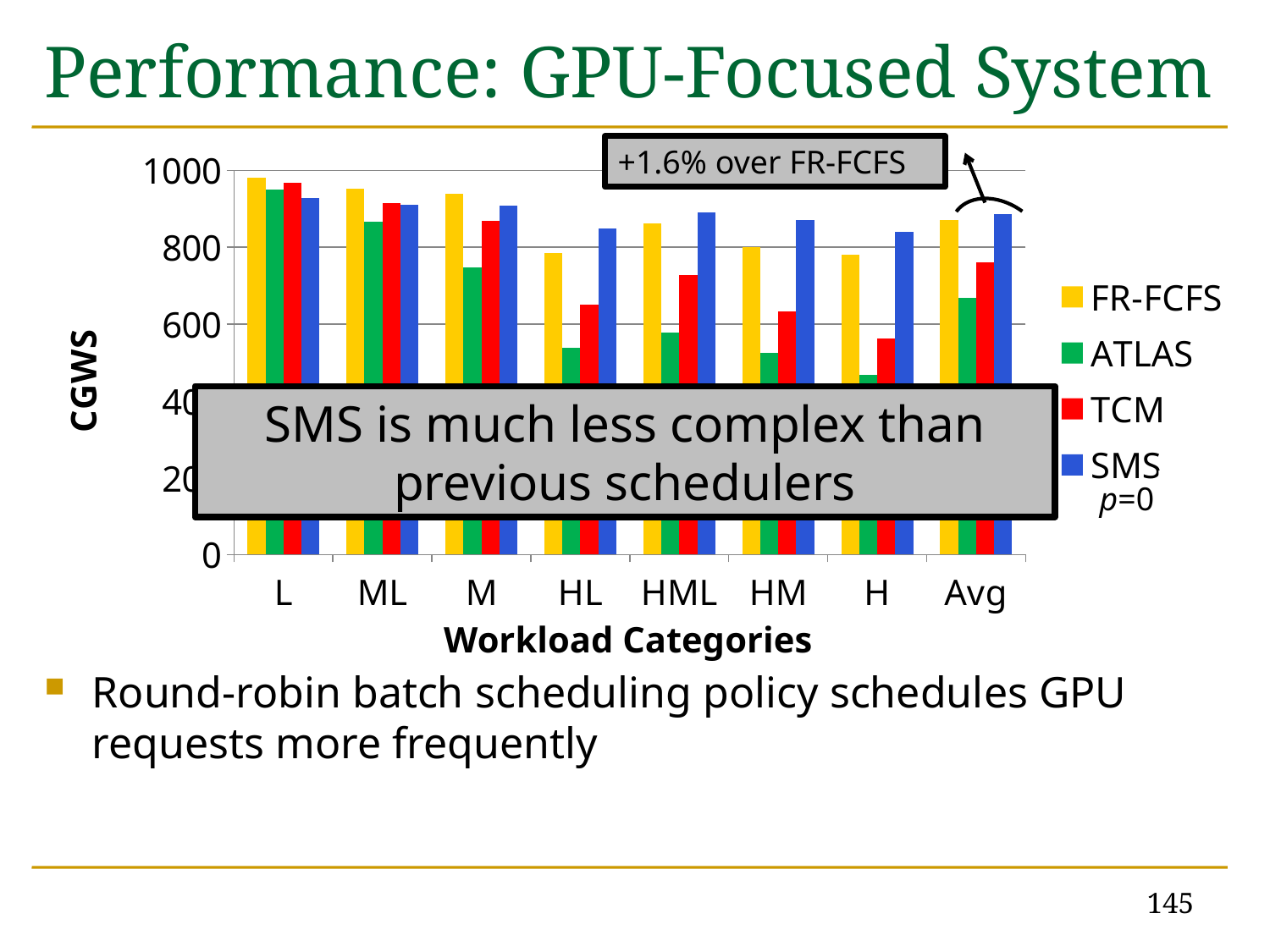
Is the ATLAS value for M greater or less than 800? less How many workload categories are shown on the x axis? 8 Is the ATLAS value for HL greater or less than 600? less For the HL category, which is larger, FR-FCFS or ATLAS? FR-FCFS Which series is shown in blue in the legend? SMS Across the workload categories, which category has the highest FR-FCFS value? L Is the SMS value for HML greater or less than 800? greater What kind of chart is shown on the slide? bar chart What is the label of the y axis? CGWS How many series does the legend list? 4 For the HL category, which series has the lowest value? ATLAS